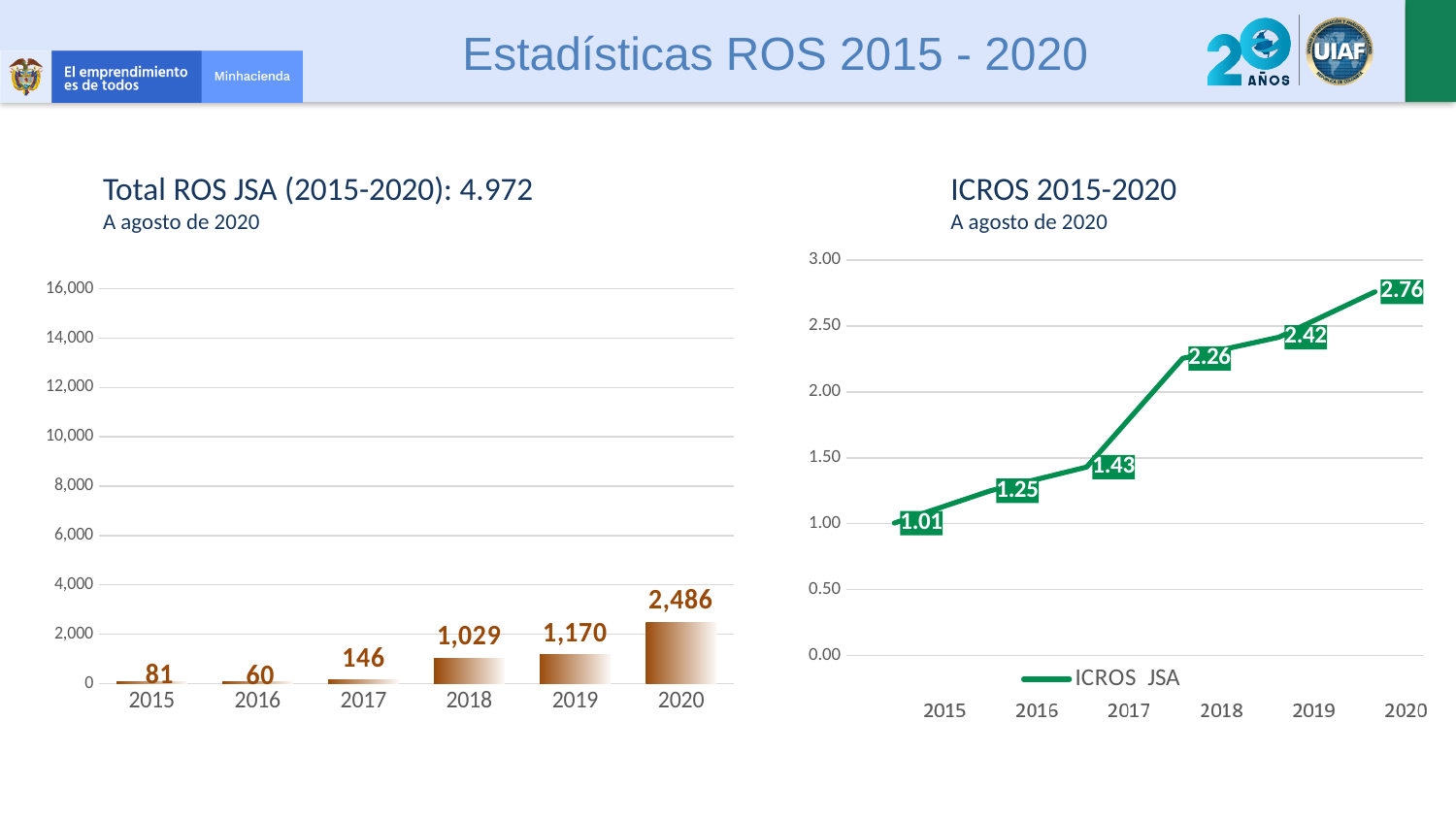
In the 'Total ROS JSA (2015-2020)' bar chart, what is the difference between the values for 2020 and 2019? 1,316 In the 'Total ROS JSA (2015-2020)' bar chart, how many years are shown on the x axis? 6 In the 'ICROS 2015-2020' line chart, do the values rise or fall from 2015 to 2020? rise In the 'Total ROS JSA (2015-2020)' bar chart, what is the value for 2018? 1,029 In the 'Total ROS JSA (2015-2020)' bar chart, which year has the lowest value? 2016 In the 'ICROS 2015-2020' line chart, what is the difference between the values for 2020 and 2015? 1.75 In the 'ICROS 2015-2020' line chart, what is the value for 2015? 1.01 In the 'ICROS 2015-2020' line chart, what is the value for 2017? 1.43 What type of chart is the 'Total ROS JSA (2015-2020)' chart? bar chart In the 'Total ROS JSA (2015-2020)' bar chart, which year has the highest value? 2020 In the 'ICROS 2015-2020' line chart, which is larger, the value for 2018 or the value for 2019? 2019 In the 'ICROS 2015-2020' line chart, what series name does the legend show? ICROS JSA